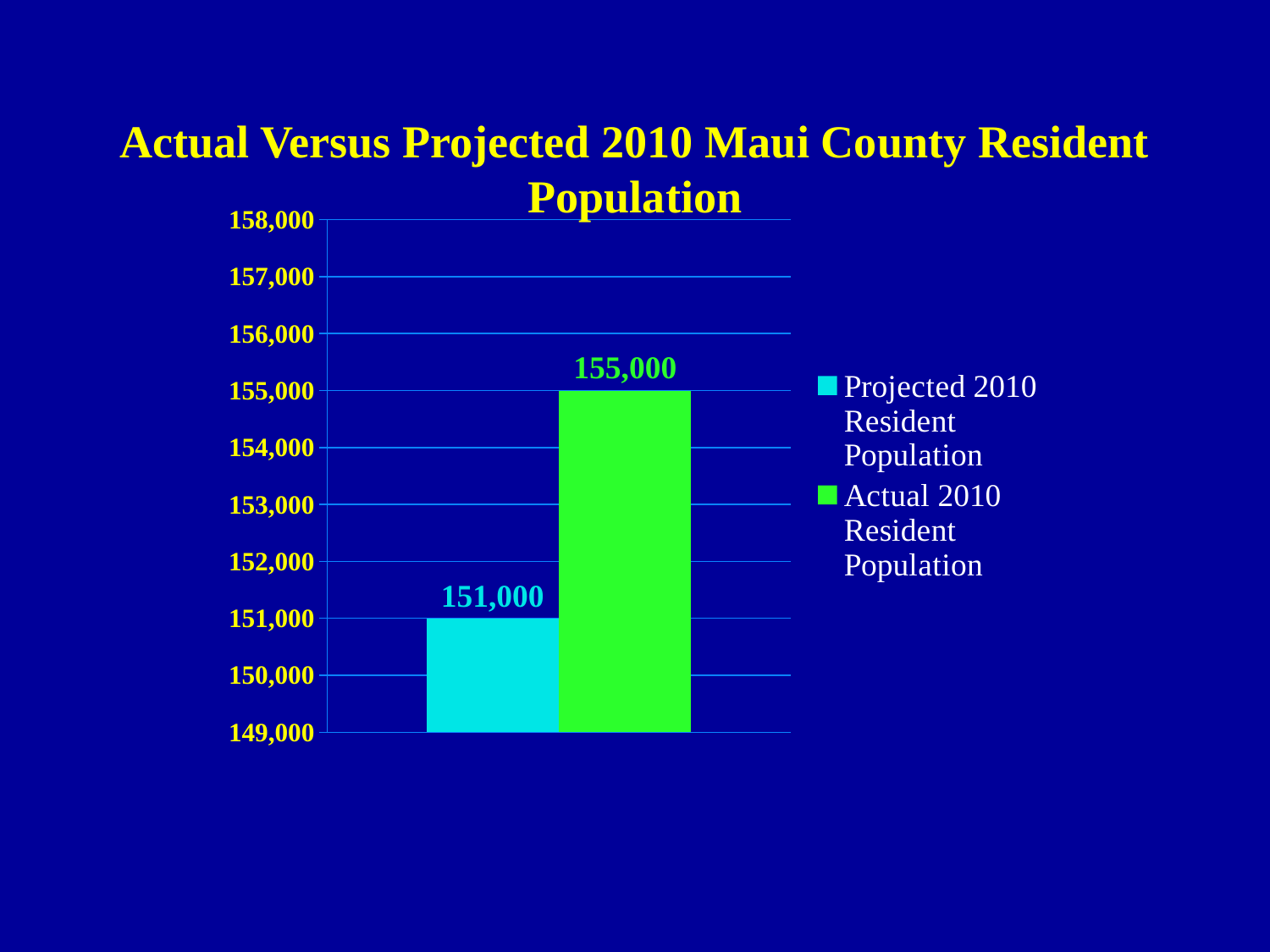
What is the title of the chart? Actual Versus Projected 2010 Maui County Resident Population Which series has the higher value, Projected 2010 Resident Population or Actual 2010 Resident Population? Actual 2010 Resident Population Is the value for Projected 2010 Resident Population greater or less than 152,000? less What is the value for Projected 2010 Resident Population? 151,000 How many series does the legend list? 2 What is the value for Actual 2010 Resident Population? 155,000 What is the difference between the Actual 2010 Resident Population and the Projected 2010 Resident Population? 4,000 Is the value for Actual 2010 Resident Population greater or less than 153,000? greater What kind of chart is shown on the slide? bar chart Is the Projected 2010 Resident Population larger or smaller than the Actual 2010 Resident Population? smaller Which series has the lower value? Projected 2010 Resident Population How many bars are plotted on the chart? 2